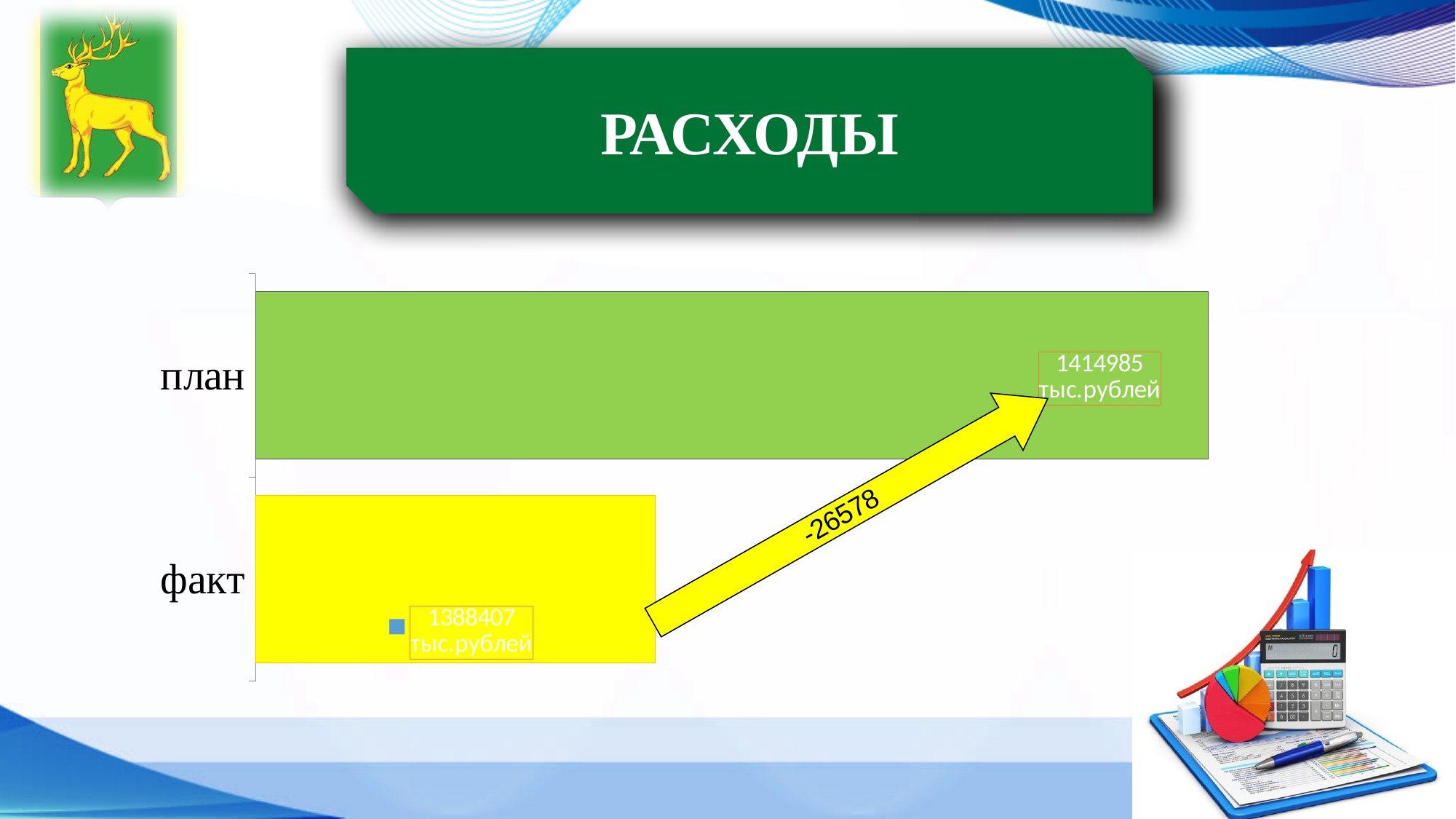
How many categories are plotted in the chart? 2 Which category has the highest value? план What number is written on the yellow arrow between the bars? -26578 What is the value shown for факт? 1388407 тыс.рублей What is the value shown for план? 1414985 тыс.рублей Which category has the higher value, план or факт? план Which category has the lowest value? факт What is the difference between the план value and the факт value? 26578 What kind of chart is shown on the slide? bar chart What is the title shown above the chart? РАСХОДЫ